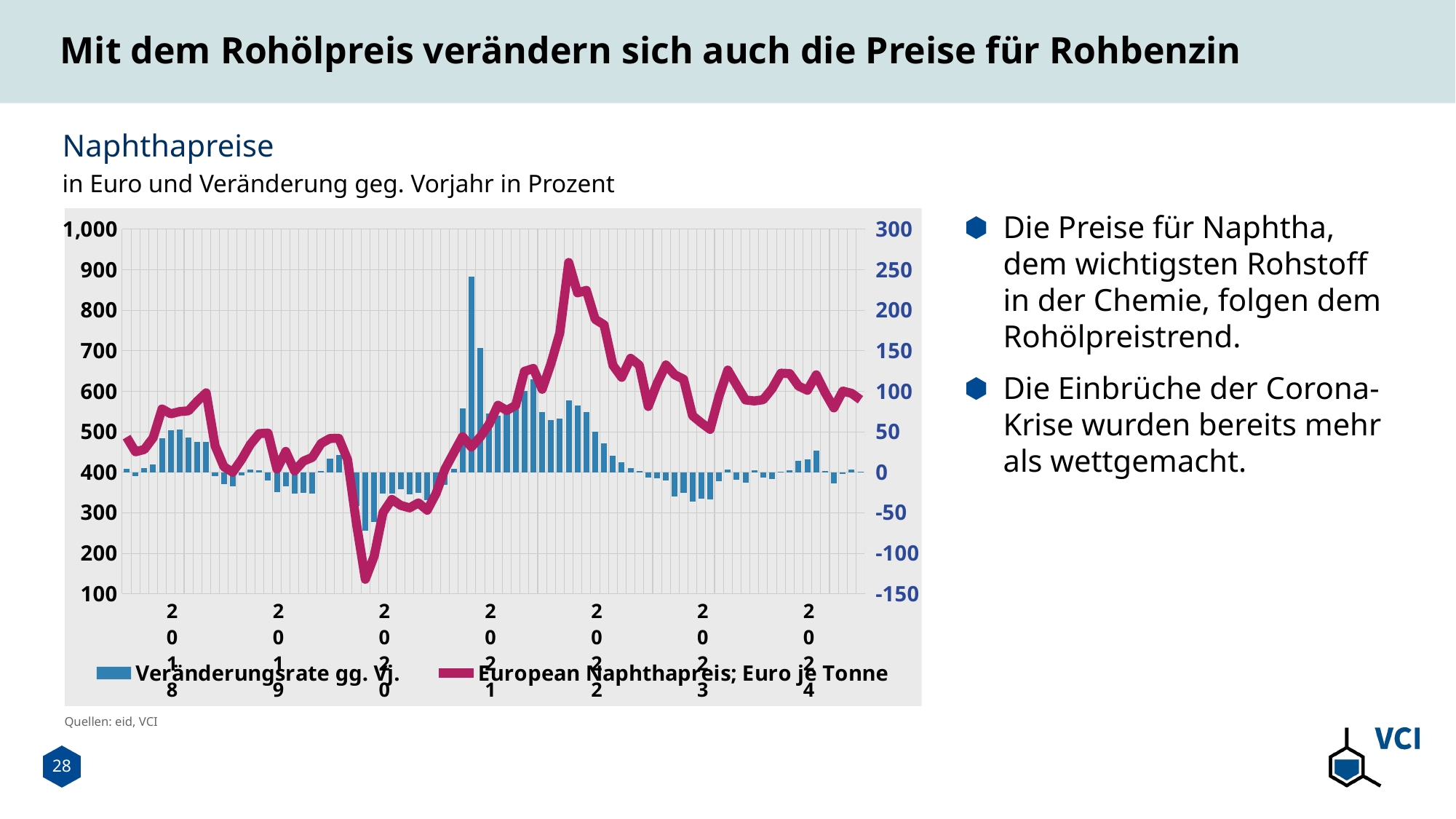
Which is higher: the European Naphthapreis line at its 2022 peak or at its 2020 low? The 2022 peak Does the European Naphthapreis line rise or fall from its 2022 peak to the end of 2024? fall How many series does the chart legend list? 2 How many year labels are shown on the x axis of the chart? 7 Which series is drawn as a line in the chart? European Naphthapreis; Euro je Tonne Is the highest bar of the Veränderungsrate gg. Vj. in 2021 greater or less than 200 on the right axis? greater Does the European Naphthapreis line rise or fall from its 2020 low to its 2022 peak? rise Which series is drawn as bars in the chart? Veränderungsrate gg. Vj. Is the lowest bar of the Veränderungsrate gg. Vj. in 2020 greater or less than -50 on the right axis? less Is the peak value of the European Naphthapreis line in 2022 greater or less than 800? greater What kind of chart is shown on the slide? A combined bar and line chart